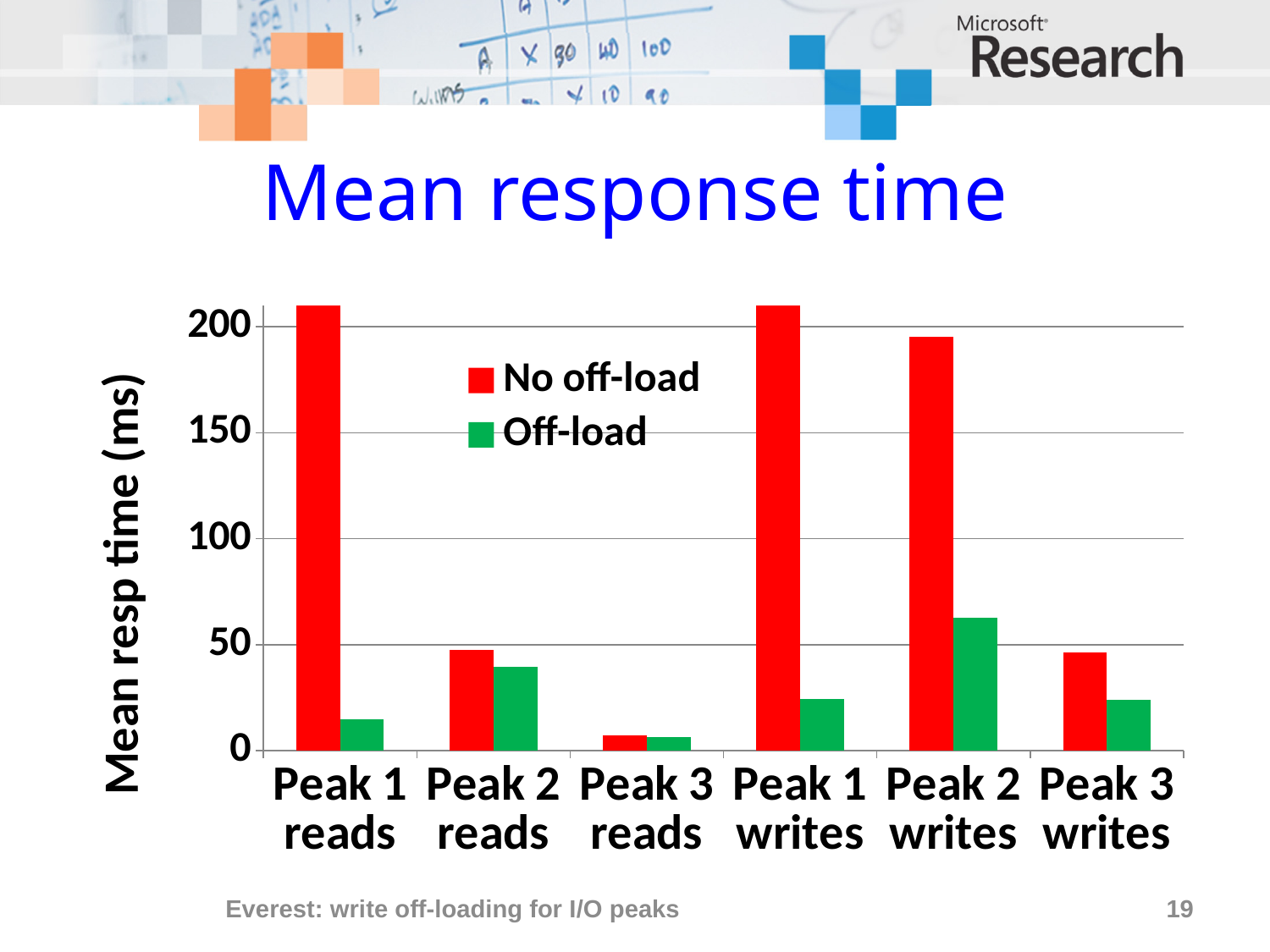
For Peak 2 reads, which is larger: the No off-load value or the Off-load value? No off-load Is the No off-load value for Peak 1 reads greater or less than 200? greater How many series does the legend list? 2 Is the Off-load value for Peak 1 writes greater or less than 50? less How many categories are shown on the x axis? 6 Is the No off-load value for Peak 2 writes greater or less than 150? greater What kind of chart is shown on the slide? bar chart Which category has the lowest No off-load value? Peak 3 reads Which category has the highest Off-load value? Peak 2 writes What is the title of the y axis? Mean resp time (ms)